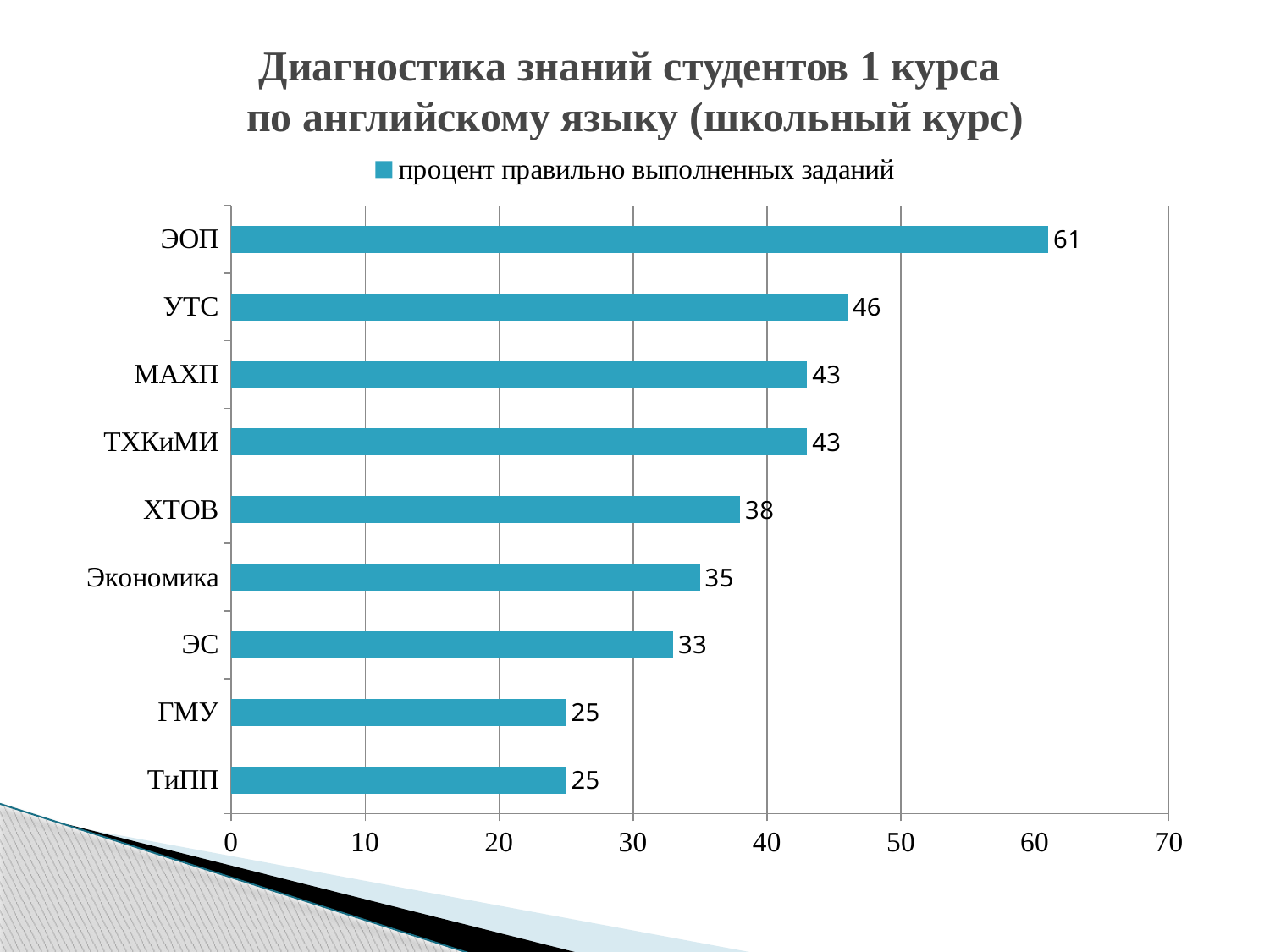
What is the value for ХТОВ? 38 What is the value for ЭОП? 61 How many series does the legend list? 1 What is the legend entry of the chart? процент правильно выполненных заданий What kind of chart is shown on the slide? bar chart How many categories are shown on the chart? 9 Which is larger, the value for УТС or the value for МАХП? УТС What is the value for Экономика? 35 What is the difference between the values for ЭОП and УТС? 15 Is the value for ЭОП greater or less than 50? greater Which category has the highest value? ЭОП What is the difference between the values for ХТОВ and ЭС? 5